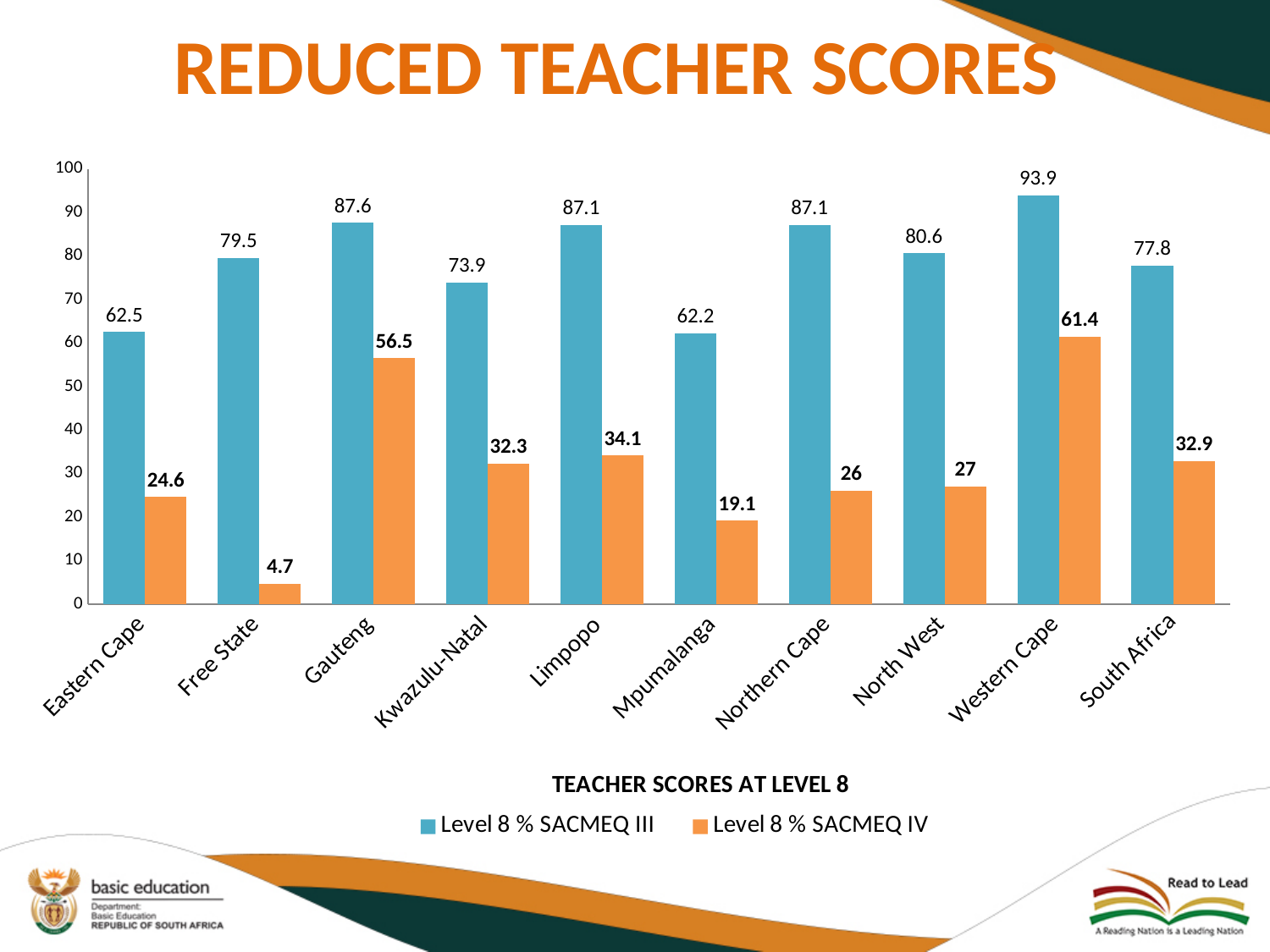
What is the Level 8 % SACMEQ III value for Gauteng? 87.6 What is the Level 8 % SACMEQ IV value for South Africa? 32.9 Is the Level 8 % SACMEQ IV value for Gauteng greater or less than 50? greater Which is larger for Mpumalanga: the Level 8 % SACMEQ III value or the Level 8 % SACMEQ IV value? Level 8 % SACMEQ III What is the difference between the Level 8 % SACMEQ III and Level 8 % SACMEQ IV values for Western Cape? 32.5 Which category has the highest Level 8 % SACMEQ III value? Western Cape What kind of chart is shown on the slide? Bar chart Which category has the lowest Level 8 % SACMEQ IV value? Free State How many series does the legend list? 2 How many categories are shown on the x axis? 10 What is the title of the chart? TEACHER SCORES AT LEVEL 8 What is the Level 8 % SACMEQ IV value for Free State? 4.7